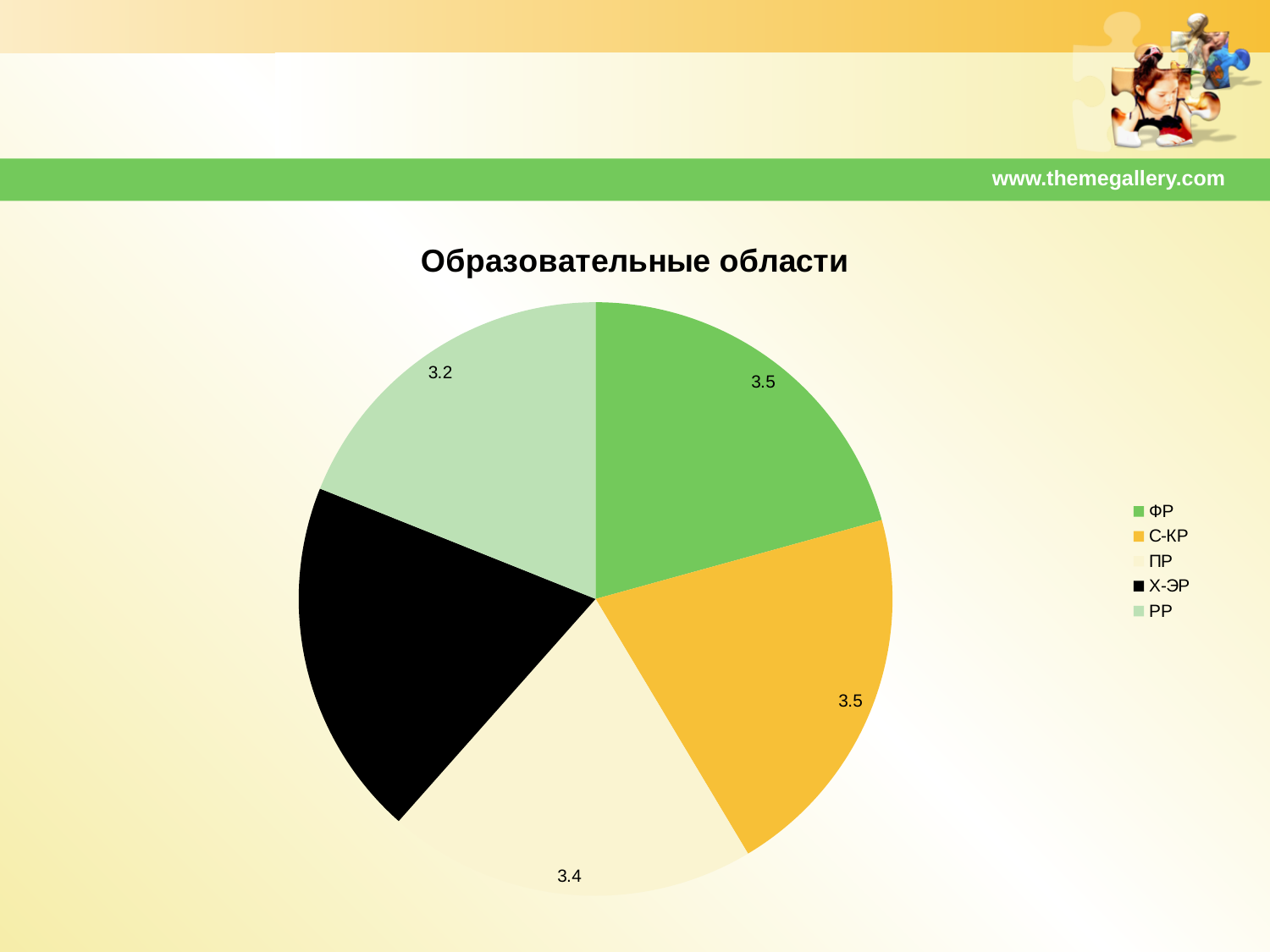
What is the value shown for ФР? 3.5 What is the difference between the values for ПР and РР? 0.2 How many slices does the pie chart have? 5 How many entries does the legend list? 5 What is the value shown for РР? 3.2 What is the value shown for ПР? 3.4 What is the value shown for С-КР? 3.5 What is the title of the chart? Образовательные области Which has the larger value, ПР or РР? ПР What colour is the slice for Х-ЭР? black What is the difference between the values for ФР and РР? 0.3 What kind of chart is shown on the slide? pie chart